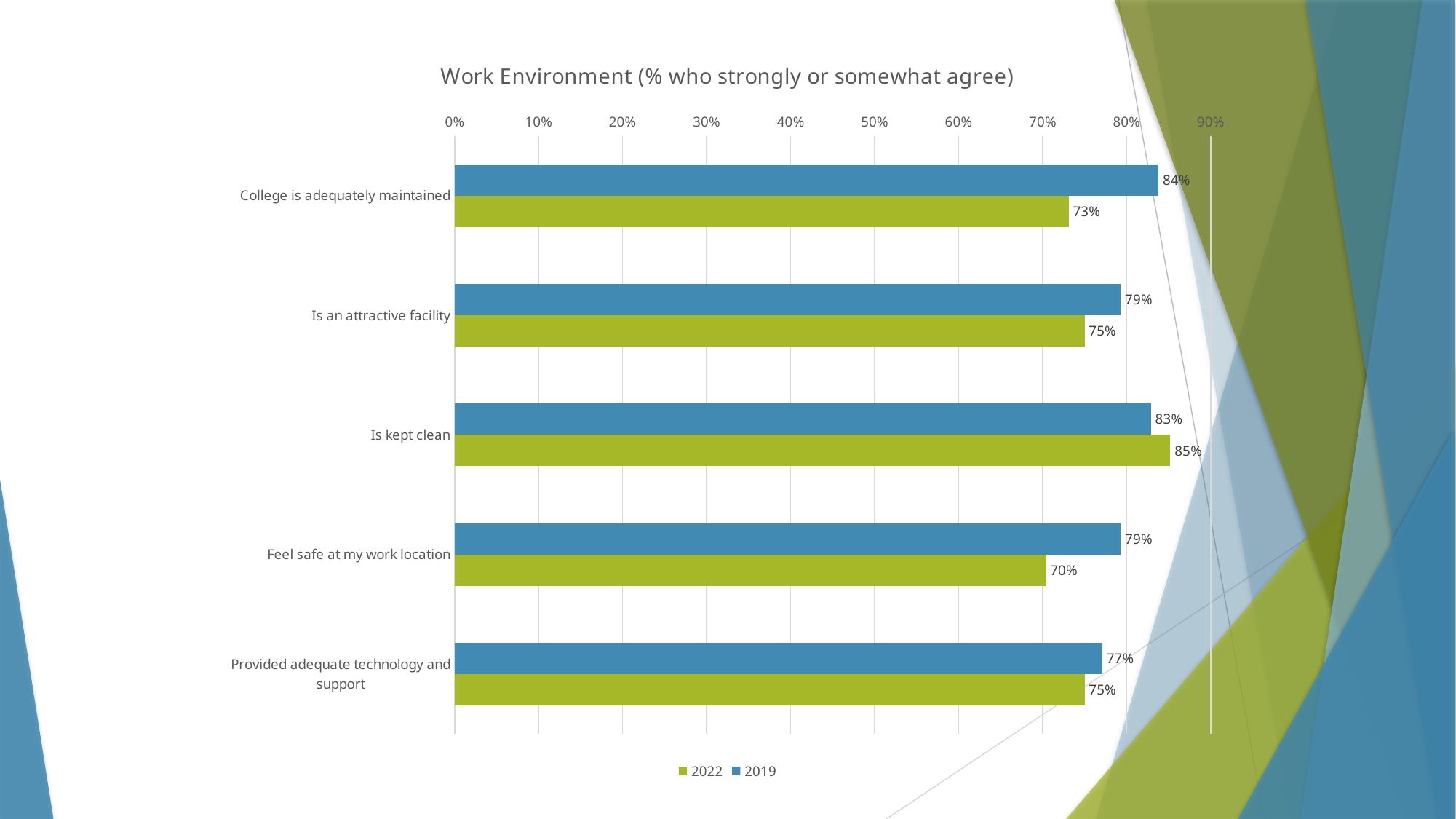
Which category has the lowest 2022 value? Feel safe at my work location What is the 2022 value for "Feel safe at my work location"? 70% For "Is kept clean", which year has the larger value, 2019 or 2022? 2022 What is the 2019 value for "Provided adequate technology and support"? 77% What is the 2019 value for "College is adequately maintained"? 84% How many series does the legend list? 2 What is the title of the chart? Work Environment (% who strongly or somewhat agree) What is the 2022 value for "Is kept clean"? 85% What is the difference between the 2019 and 2022 values for "College is adequately maintained"? 11% What kind of chart is shown on the slide? Bar chart How many categories are shown on the chart? 5 Which category has the highest 2022 value? Is kept clean